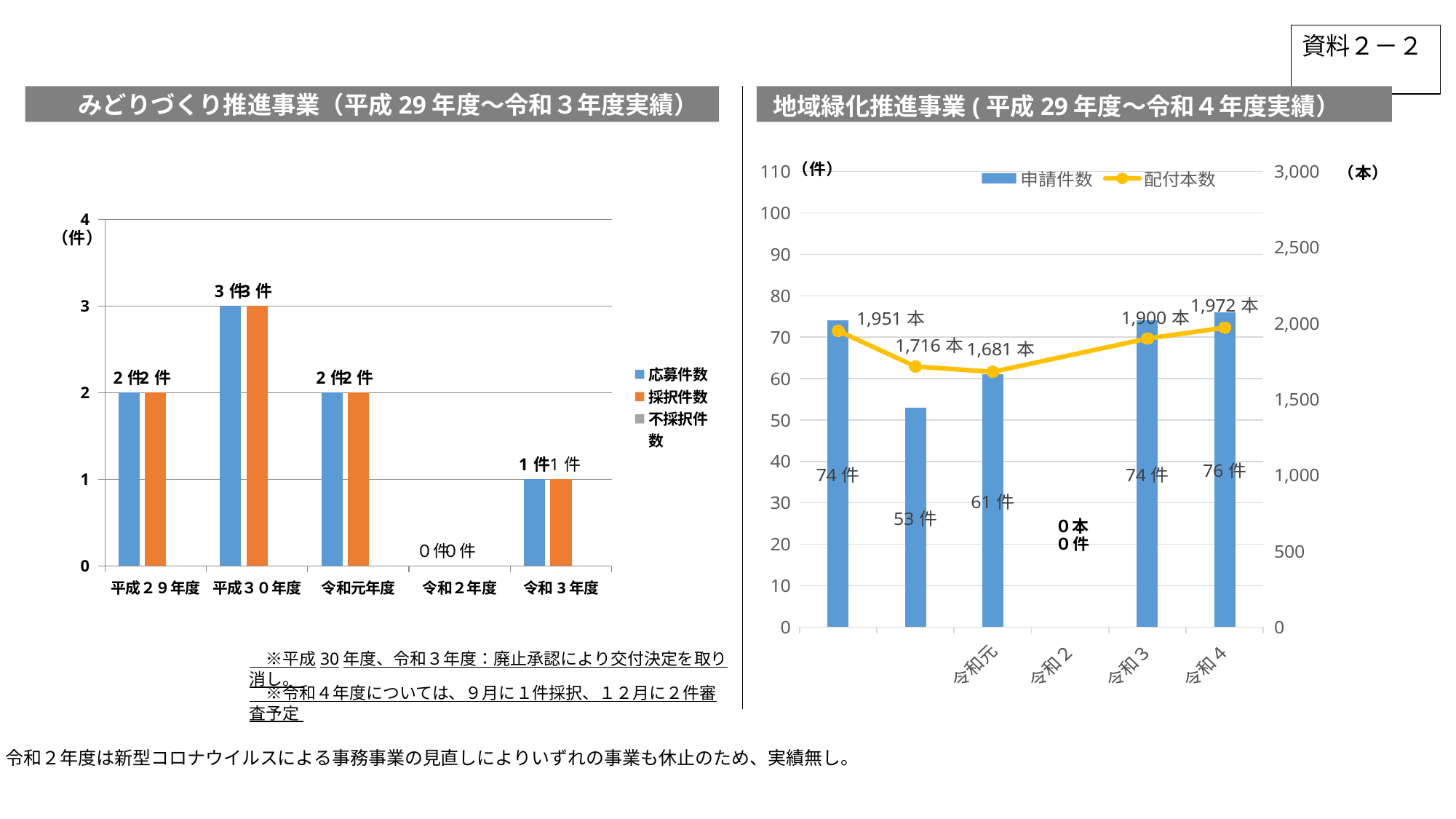
In the left chart (みどりづくり推進事業), what is the 応募件数 value for 平成30年度? 3件 In the right chart (地域緑化推進事業), what is the 配付本数 value for 令和元? 1,681本 What kind of chart is the left chart (みどりづくり推進事業)? Bar chart In the right chart (地域緑化推進事業), what is the difference between the 配付本数 for 令和4 and for 令和3? 72本 In the right chart (地域緑化推進事業), which series is drawn as a line with markers? 配付本数 In the left chart (みどりづくり推進事業), what is the difference between the 応募件数 for 平成30年度 and for 令和3年度? 2件 In the left chart (みどりづくり推進事業), how many year categories are shown on the x axis? 5 In the left chart (みどりづくり推進事業), how many series does the legend list? 3 In the right chart (地域緑化推進事業), what is the 申請件数 value for 令和4? 76件 In the right chart (地域緑化推進事業), which is larger, the 配付本数 for 令和3 or for 令和4? 令和4 In the left chart (みどりづくり推進事業), which year has the highest 応募件数? 平成30年度 In the left chart (みどりづくり推進事業), what is the 採択件数 value for 令和3年度? 1件